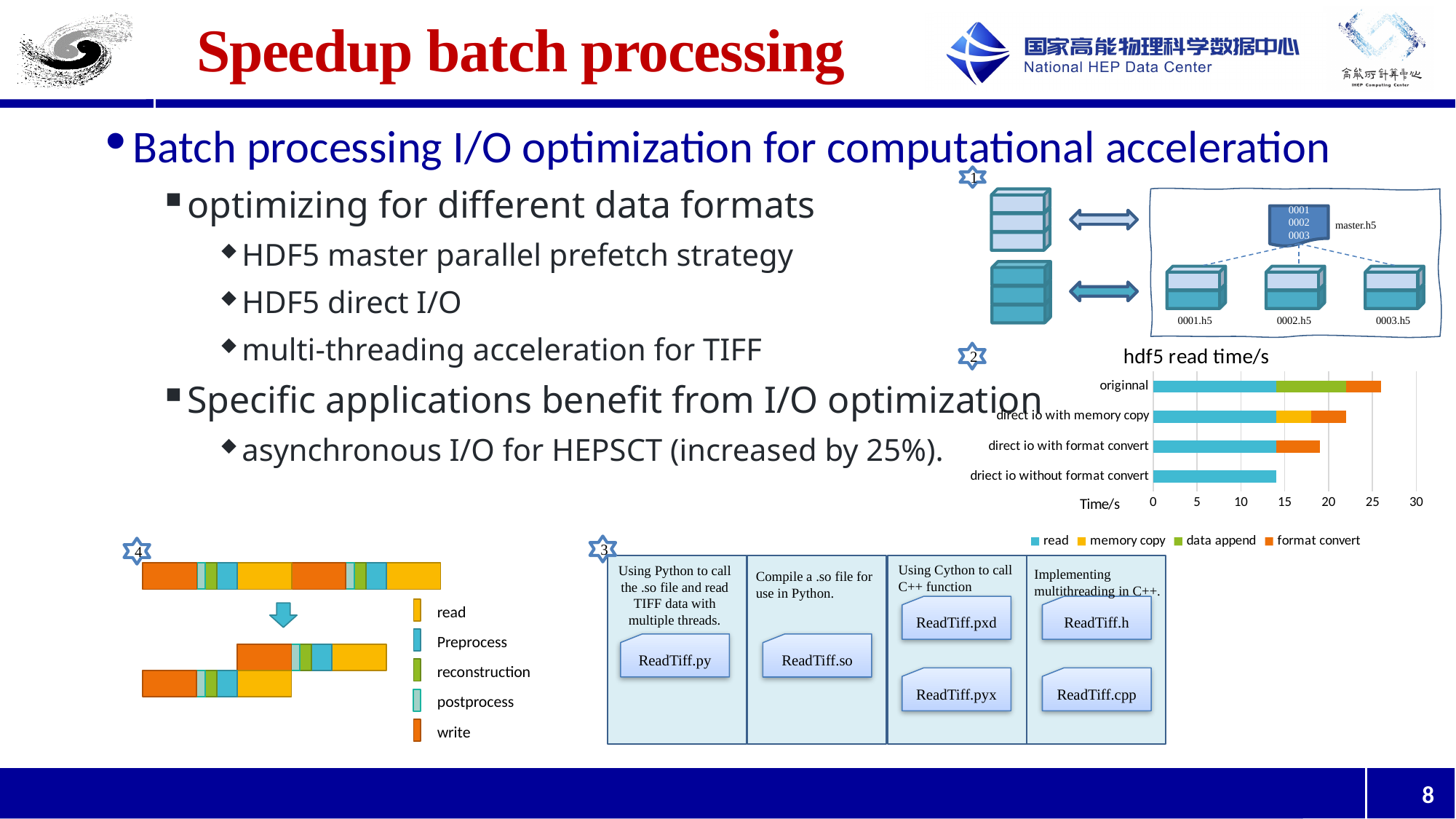
In the "hdf5 read time/s" chart, which category has the shortest total bar? driect io without format convert In the "hdf5 read time/s" chart, is the total bar for "direct io with memory copy" greater or less than 20? greater What kind of chart is the "hdf5 read time/s" chart? Stacked horizontal bar chart How many categories are shown on the "hdf5 read time/s" chart? 4 In the "hdf5 read time/s" chart, is the total bar for "driect io without format convert" greater or less than 20? less What is the title of the bar chart on the slide? hdf5 read time/s In the "hdf5 read time/s" chart, which total bar is longer: "direct io with memory copy" or "direct io with format convert"? direct io with memory copy In the "hdf5 read time/s" chart, which category has the longest total bar? originnal In the "hdf5 read time/s" chart, which series is the only one present in the "driect io without format convert" bar? read In the "hdf5 read time/s" chart, is the total bar for "originnal" greater or less than 20? greater How many series does the legend of the "hdf5 read time/s" chart list? 4